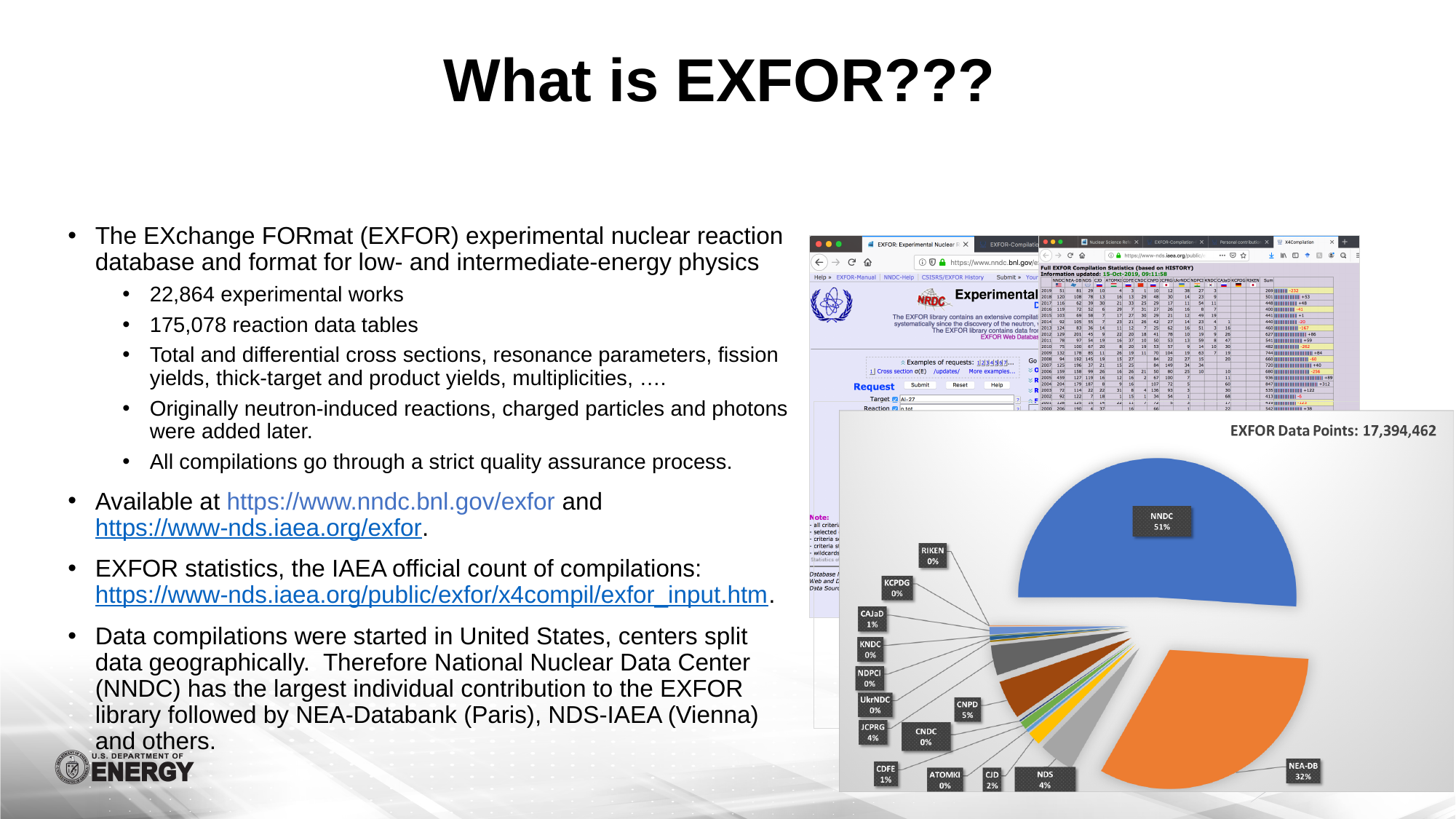
How many data centers are labelled in the pie chart? 15 What percentage is shown for NDS in the pie chart? 4% What percentage is shown for RIKEN in the pie chart? 0% What share of EXFOR data points does NNDC contribute according to the pie chart? 51% What kind of chart is shown on the right side of the slide? pie chart Which data center has the largest slice in the pie chart? NNDC Which is larger in the pie chart, the share for JCPRG or the share for CDFE? JCPRG What percentage is shown for CNPD in the pie chart? 5% By how many percentage points does NNDC's share exceed NEA-DB's share in the pie chart? 19 What share of EXFOR data points does NEA-DB contribute according to the pie chart? 32% What is the title of the pie chart? EXFOR Data Points: 17,394,462 What percentage is shown for CJD in the pie chart? 2%